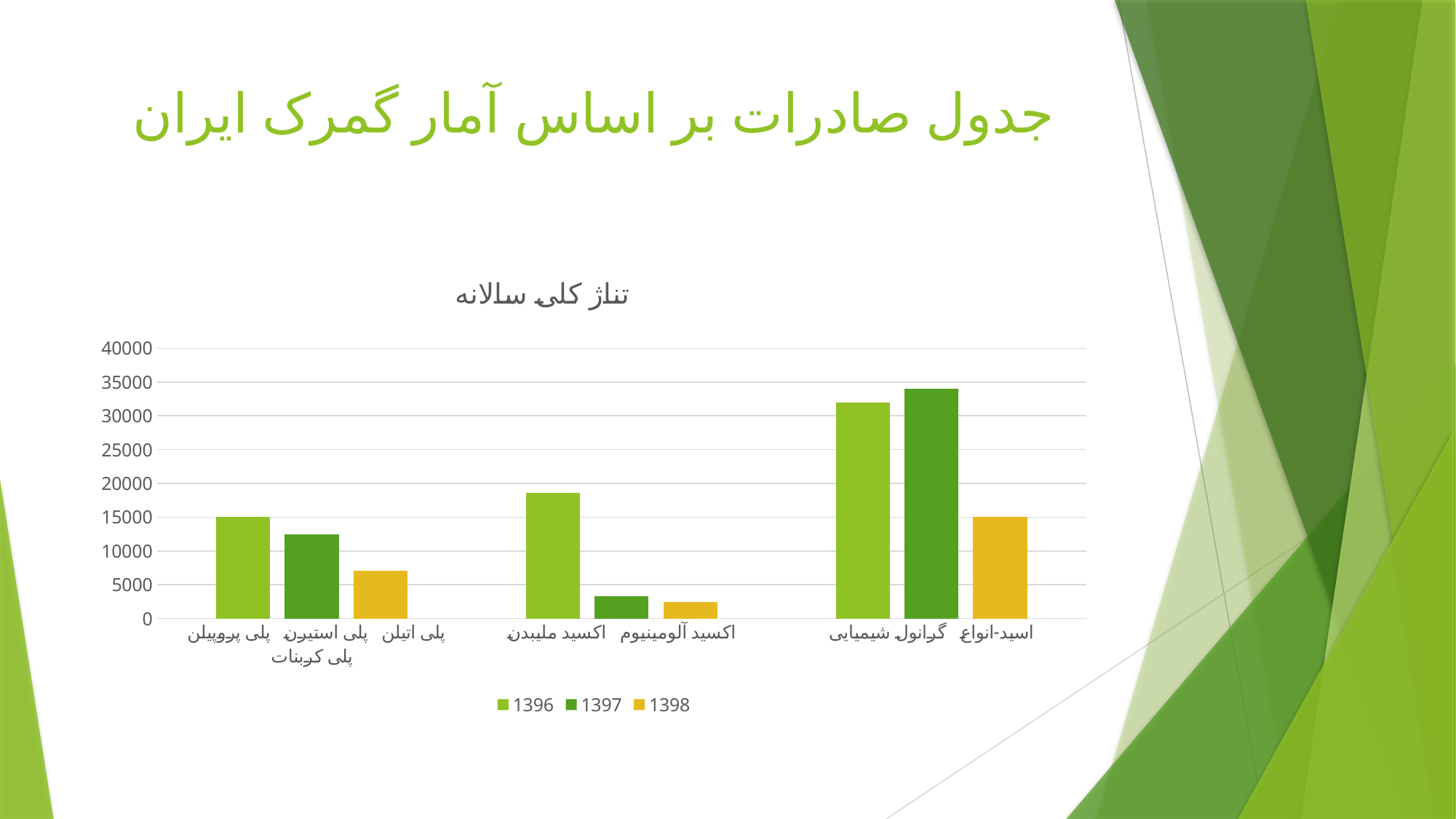
How many category groups are shown on the x axis? 3 Is the 1396 value for اکسید مولیبدن اکسید آلومینیوم greater or less than 15000? greater For اسید-انواع گرانول شیمیایی, which series has the larger value, 1397 or 1398? 1397 What kind of chart is shown on the slide? bar chart How many series does the legend list? 3 Which category group has the lowest bar for the 1398 series? اکسید آلومینیوم اکسید ملیبدن Is the 1397 value for اکسید مولیبدن اکسید آلومینیوم greater or less than 5000? less For اکسید مولیبدن اکسید آلومینیوم, which series has the larger value, 1396 or 1397? 1396 What is the title of the chart? تناژ کلی سالانه Which series is shown in yellow in the legend? 1398 Which category group has the highest bar for the 1397 series? اسید-انواع گرانول شیمیایی Is the 1397 value for اسید-انواع گرانول شیمیایی greater or less than 30000? greater